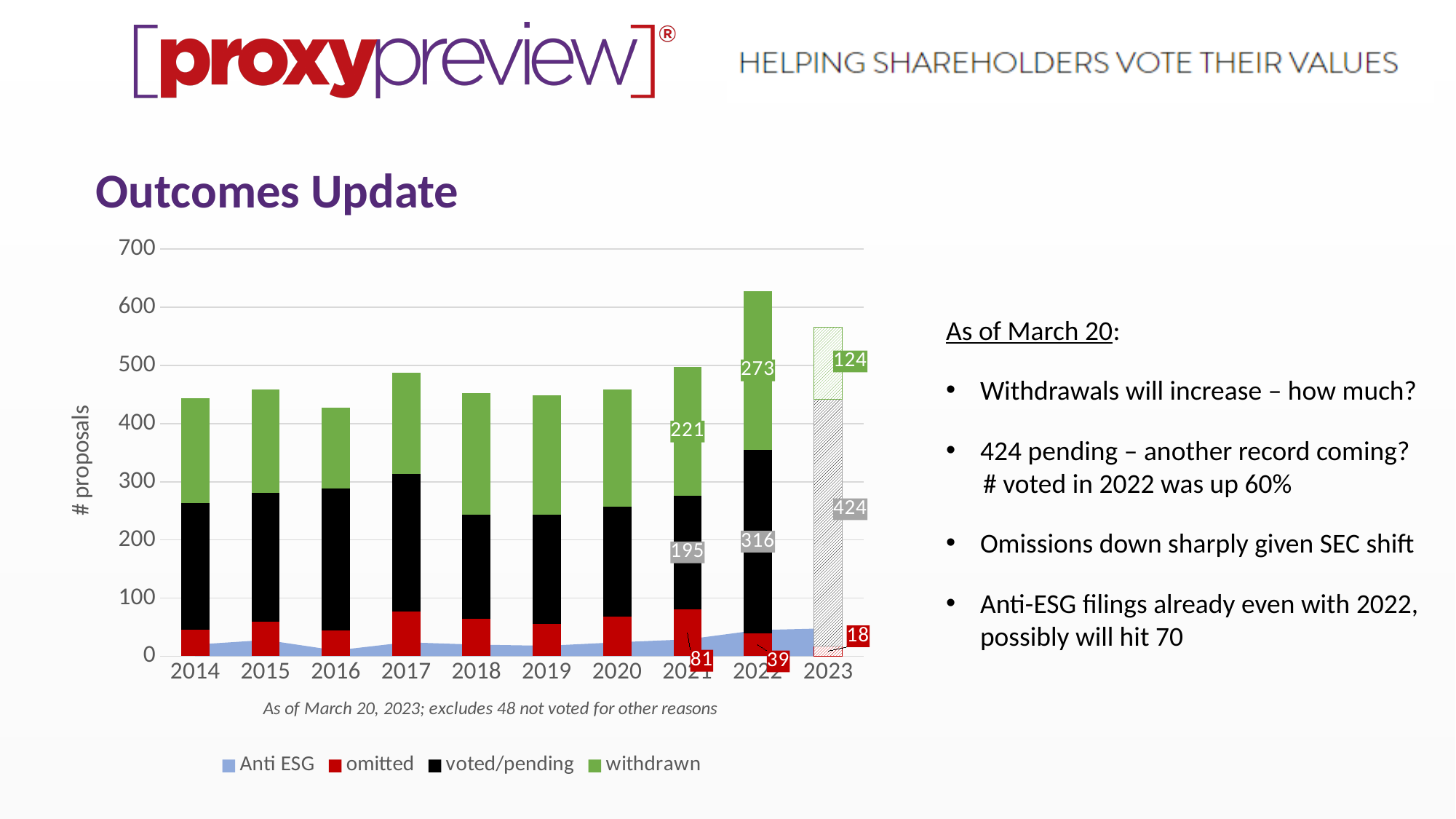
How many years are shown on the x axis? 10 Which is larger, the omitted value for 2022 or for 2023? 2022 What is the withdrawn value for 2021? 221 What is the difference between the voted/pending values for 2022 and 2021? 121 What kind of chart is shown on the slide? combination chart: stacked bar chart with an area series What is the total of the stacked bar for 2022 (omitted, voted/pending and withdrawn)? 628 Which year has the tallest stacked bar? 2022 What is the voted/pending value for 2023? 424 What is the omitted value for 2021? 81 Is the total stacked bar for 2016 greater or less than 500? less What is the withdrawn value for 2022? 273 How many series does the legend list? 4